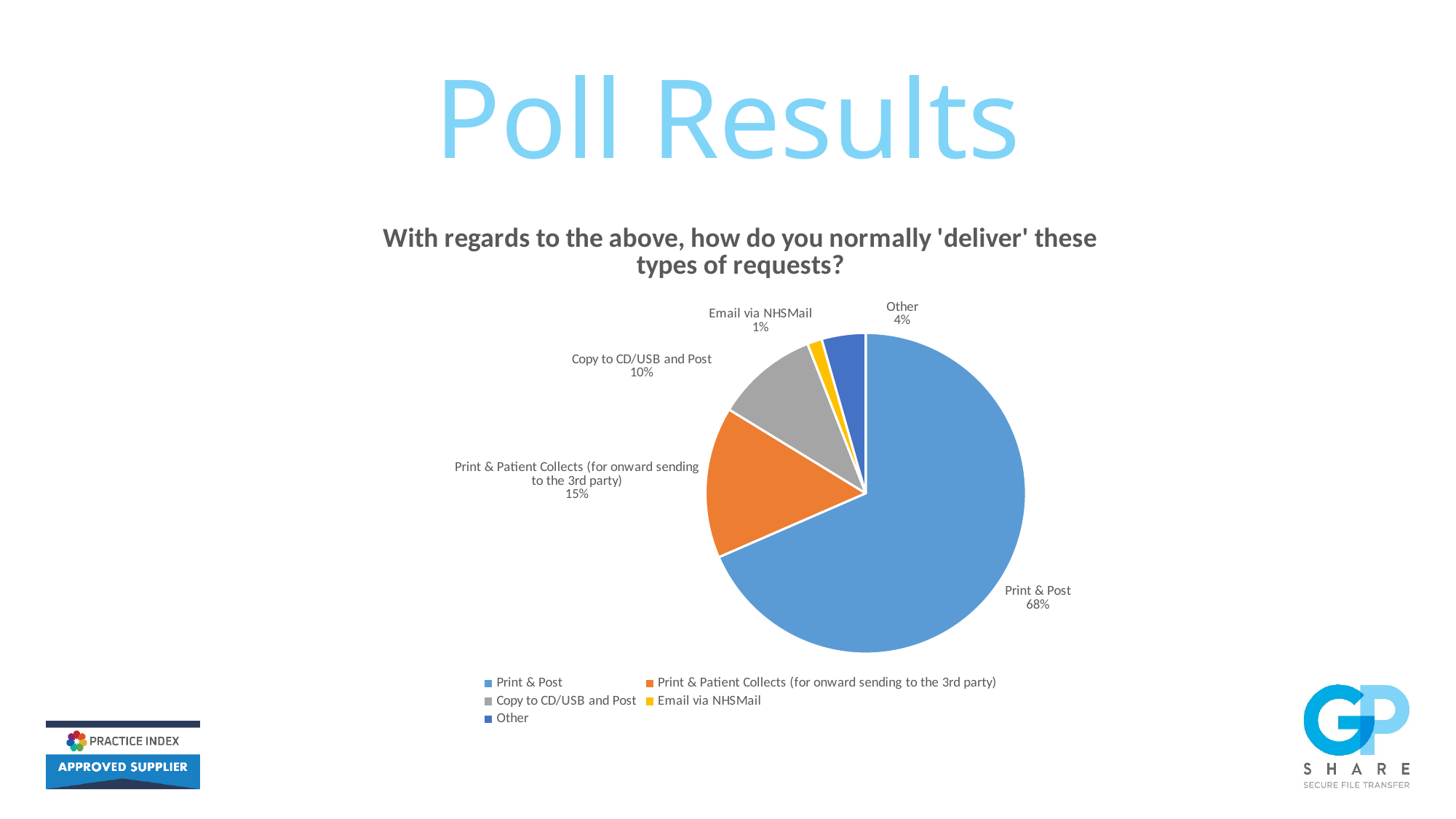
What percentage is shown for Email via NHSMail? 1% Which category has the smallest slice of the pie? Email via NHSMail What percentage of respondents chose Print & Post? 68% How many categories does the pie chart show? 5 What colour is the Email via NHSMail slice? Yellow Which is larger, Copy to CD/USB and Post or Other? Copy to CD/USB and Post What share of the pie is Copy to CD/USB and Post? 10% What is the difference in percentage points between Print & Post and Print & Patient Collects (for onward sending to the 3rd party)? 53 What type of chart is shown on the slide? Pie chart What percentage is shown for Other? 4% Which category has the largest slice of the pie? Print & Post What percentage is shown for Print & Patient Collects (for onward sending to the 3rd party)? 15%